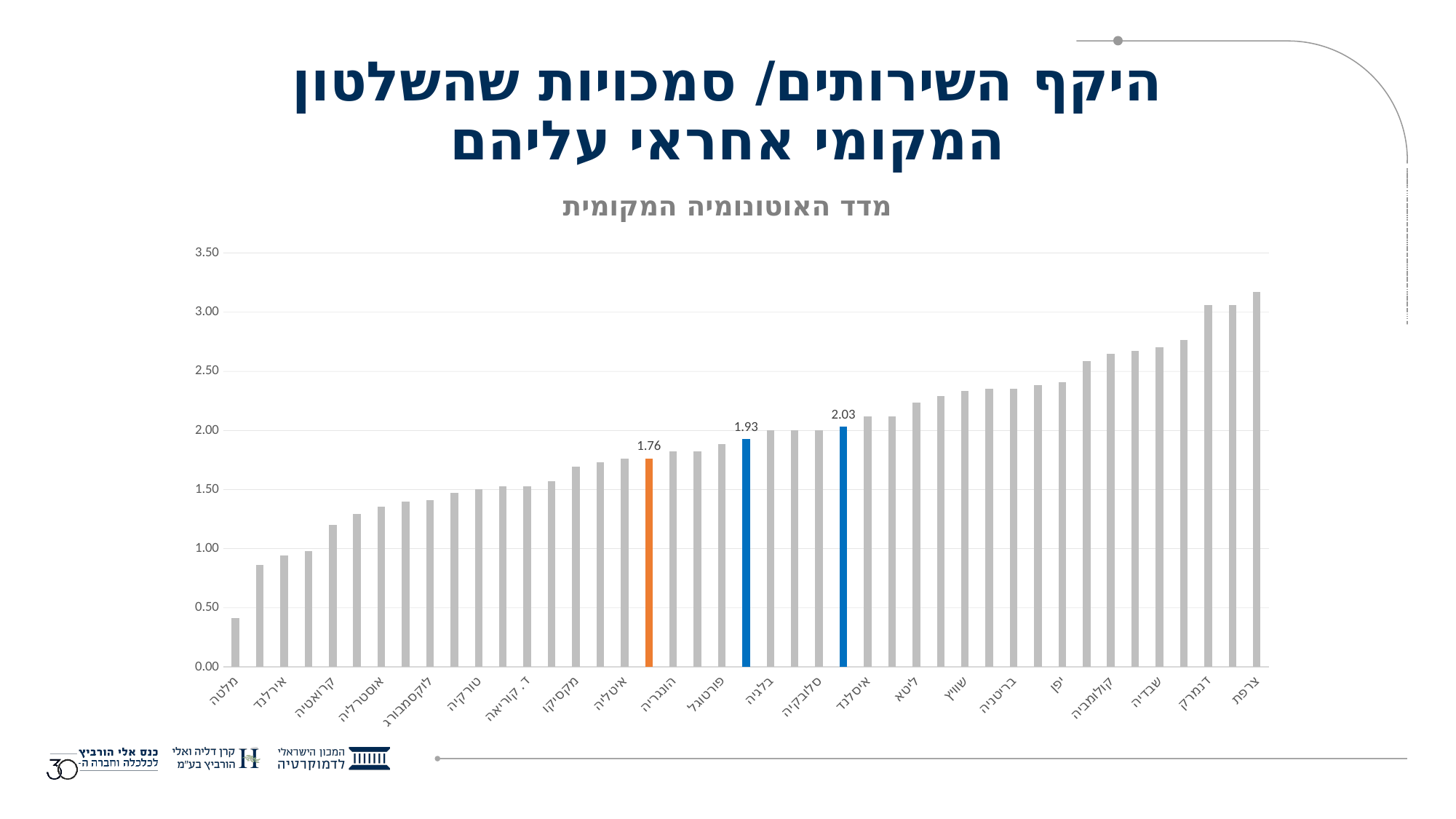
What is the value shown on the right-hand blue bar? 2.03 Is the value for צרפת greater or less than 3.00? greater What is the difference between the two blue bars (2.03 and 1.93)? 0.10 Which labelled country has the highest value on the chart? צרפת What is the value shown on the left-hand blue bar? 1.93 Which labelled country has the lowest value on the chart? מלטה What kind of chart is shown on the slide? bar chart Which is larger, the orange bar or the left-hand blue bar? the left-hand blue bar Is the value for מלטה greater or less than 0.50? less What is the value shown on the orange bar? 1.76 Do the bar values rise or fall from left to right along the x axis? rise What is the difference between the right-hand blue bar (2.03) and the orange bar (1.76)? 0.27